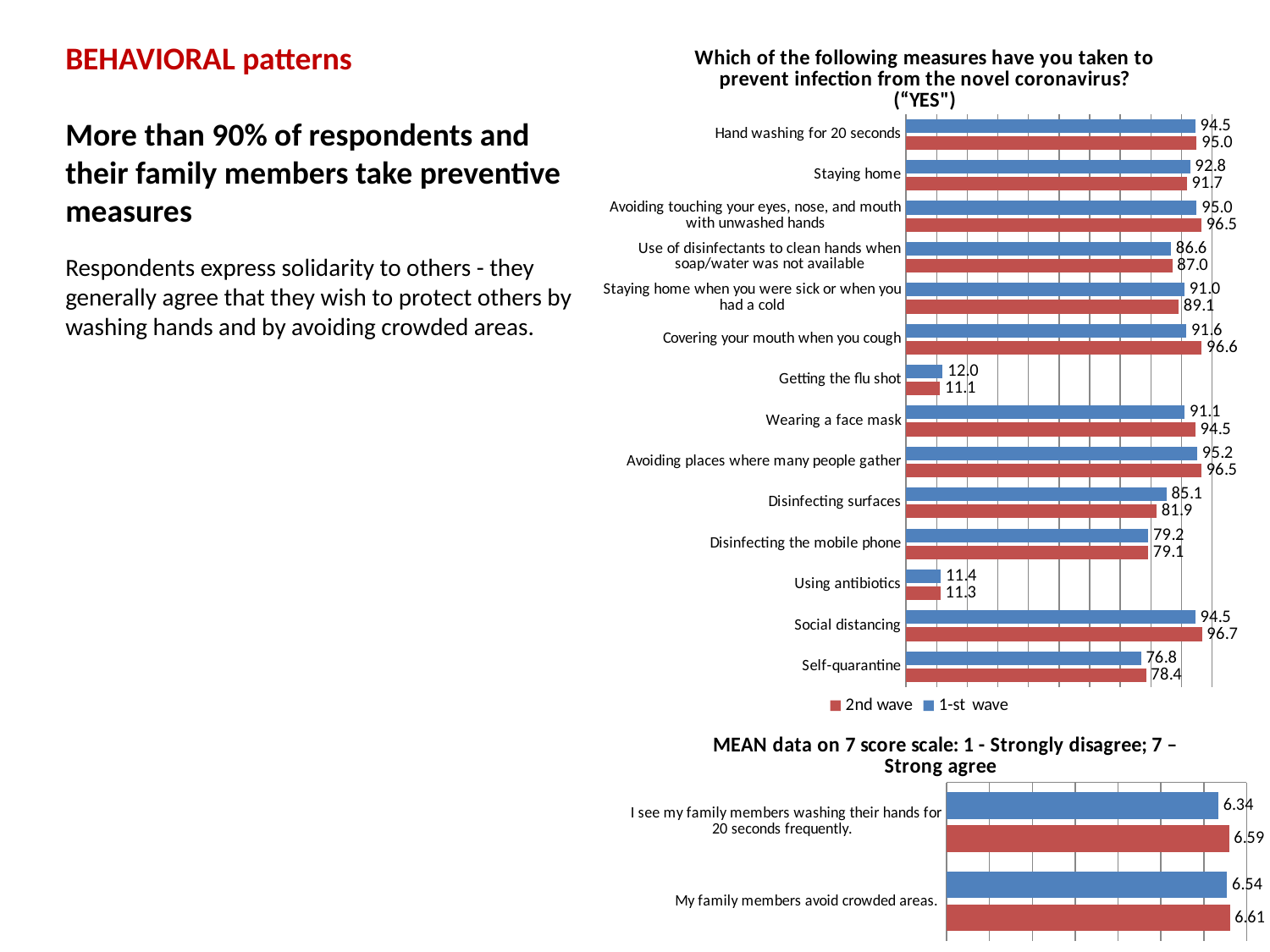
How many series does the legend of the top chart list? 2 In the bottom chart, what is the value of the blue bar for 'I see my family members washing their hands for 20 seconds frequently.'? 6.34 Which colour represents the 2nd wave in the top chart's legend? Red In the top chart, what is the 1-st wave value for Hand washing for 20 seconds? 94.5 In the top chart, which is larger for Disinfecting surfaces: the 1-st wave value or the 2nd wave value? 1-st wave In the bottom chart, what is the value of the red bar for 'My family members avoid crowded areas.'? 6.61 In the top chart, what is the 2nd wave value for Getting the flu shot? 11.1 In the top chart, what is the 2nd wave value for Social distancing? 96.7 In the top chart, what is the difference between the 2nd wave and 1-st wave values for Covering your mouth when you cough? 5.0 What kind of chart is the top chart? Bar chart How many measures (categories) are listed in the top chart? 14 In the top chart, which measure has the lowest 2nd wave value? Getting the flu shot